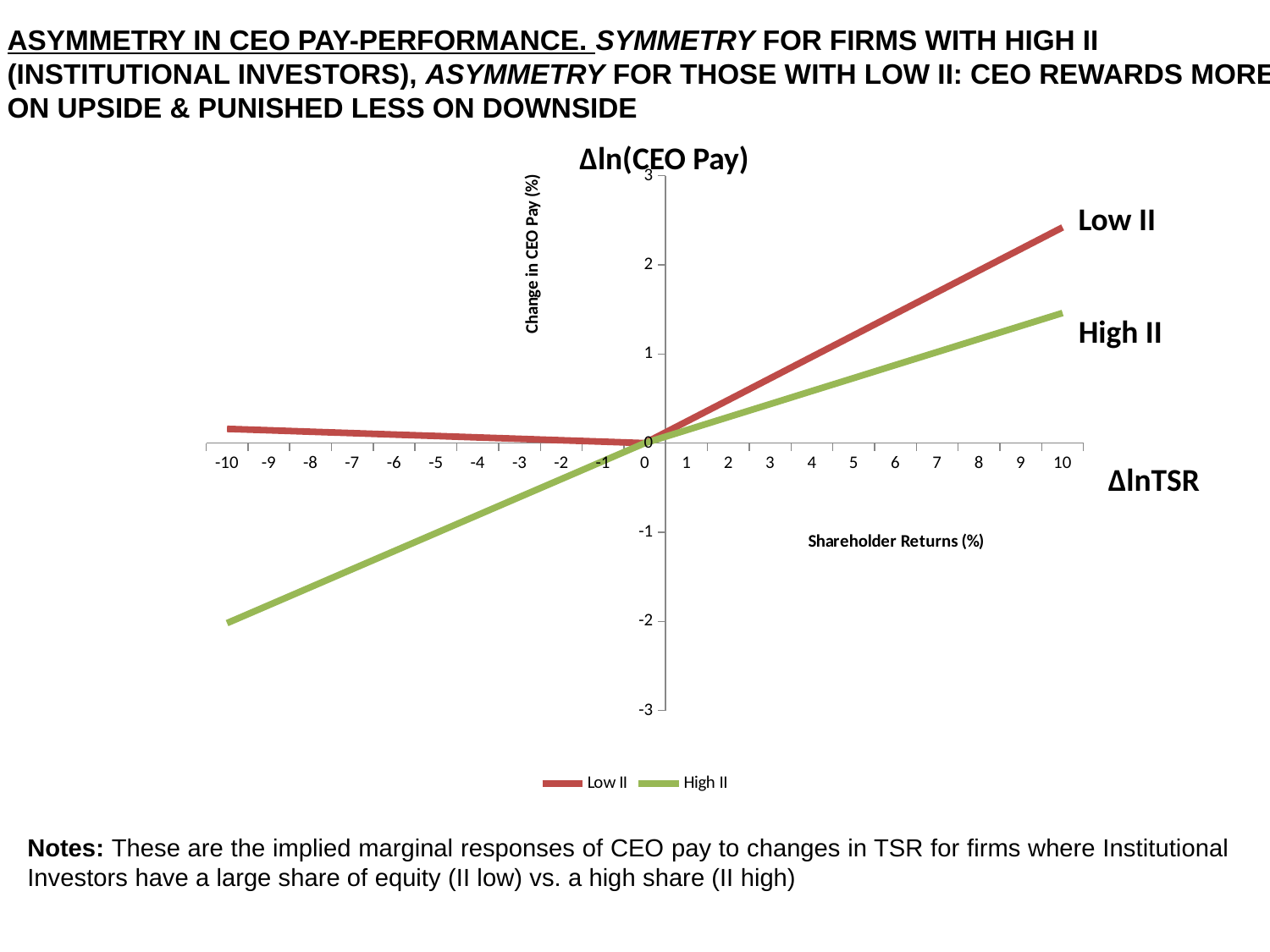
At ΔlnTSR = 10, which series has the higher Δln(CEO Pay) value, Low II or High II? Low II How many series does the legend list? 2 Is the Low II value at ΔlnTSR = 10 greater or less than 2? greater What colour is the Low II line? red Is the High II value at ΔlnTSR = -10 greater or less than -1? less What kind of chart is shown on the slide? line chart Is the Low II value at ΔlnTSR = -10 greater or less than -1? greater Does the High II line rise or fall as ΔlnTSR increases from -10 to 10? rise Which two series are listed in the legend? Low II and High II At ΔlnTSR = -10, which series has the higher Δln(CEO Pay) value, Low II or High II? Low II